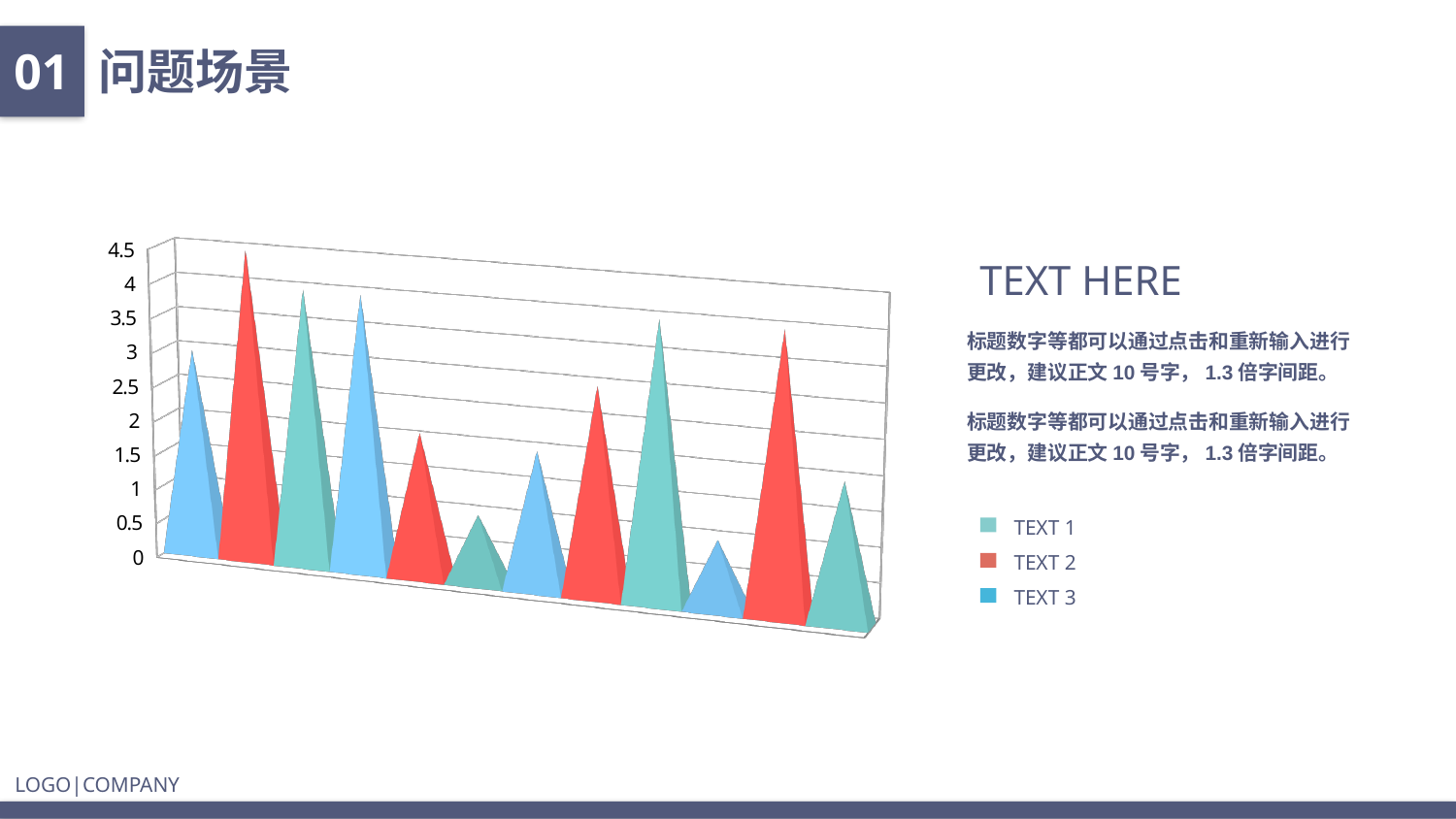
Which bar is the tallest in the chart, counting from the left? the second bar How many entries does the legend next to the chart list? 3 What is the highest value shown on the vertical axis? 4.5 Is the value of the eighth bar from the left greater or less than 2? greater Is the value of the fourth bar from the left greater or less than 3.5? greater Is the value of the second bar from the left greater or less than 4? greater Which is taller, the second bar from the left or the last bar on the right? the second bar How many bars are plotted in the chart? 12 What kind of chart is shown on the slide? bar chart